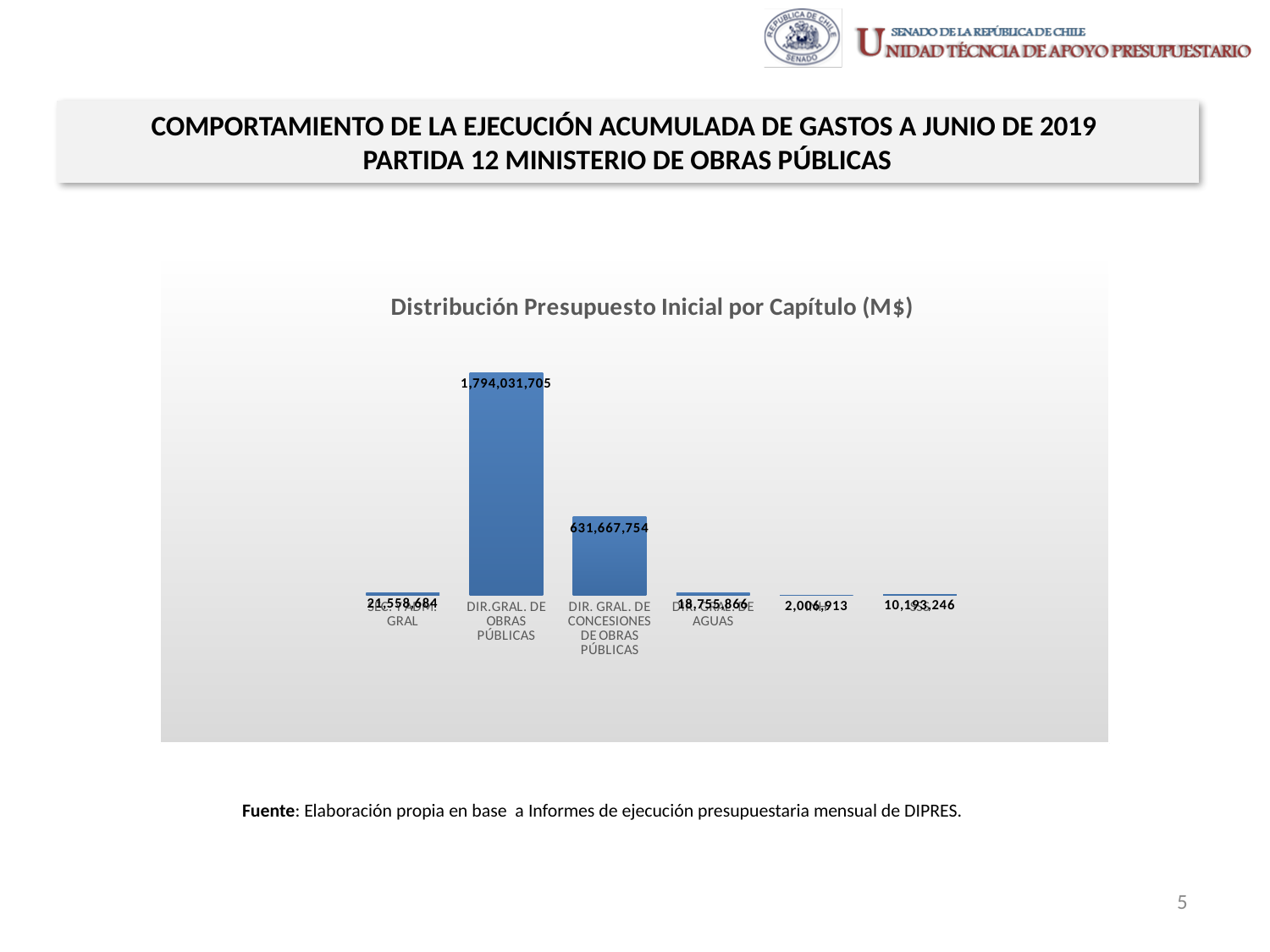
What type of chart is shown on the slide? Bar chart What is the value for DIR. GRAL. DE CONCESIONES DE OBRAS PÚBLICAS? 631,667,754 Which is larger: the value for DIR. GRAL. DE CONCESIONES DE OBRAS PÚBLICAS or the value for DIR. GRAL. DE AGUAS? DIR. GRAL. DE CONCESIONES DE OBRAS PÚBLICAS How many bars (capítulos) are shown in the chart? 6 What is the difference between the first bar's value (21,558,684) and the value for DIR. GRAL. DE AGUAS? 2,802,818 What is the title of the chart? Distribución Presupuesto Inicial por Capítulo (M$) What is the difference between the values for DIR.GRAL. DE OBRAS PÚBLICAS and DIR. GRAL. DE CONCESIONES DE OBRAS PÚBLICAS? 1,162,363,951 Which capítulo has the highest initial budget in the chart? DIR.GRAL. DE OBRAS PÚBLICAS What is the value for DIR.GRAL. DE OBRAS PÚBLICAS? 1,794,031,705 What is the lowest value shown in the chart? 2,006,913 What is the value for DIR. GRAL. DE AGUAS? 18,755,866 What unit is indicated in the chart title for the values? M$